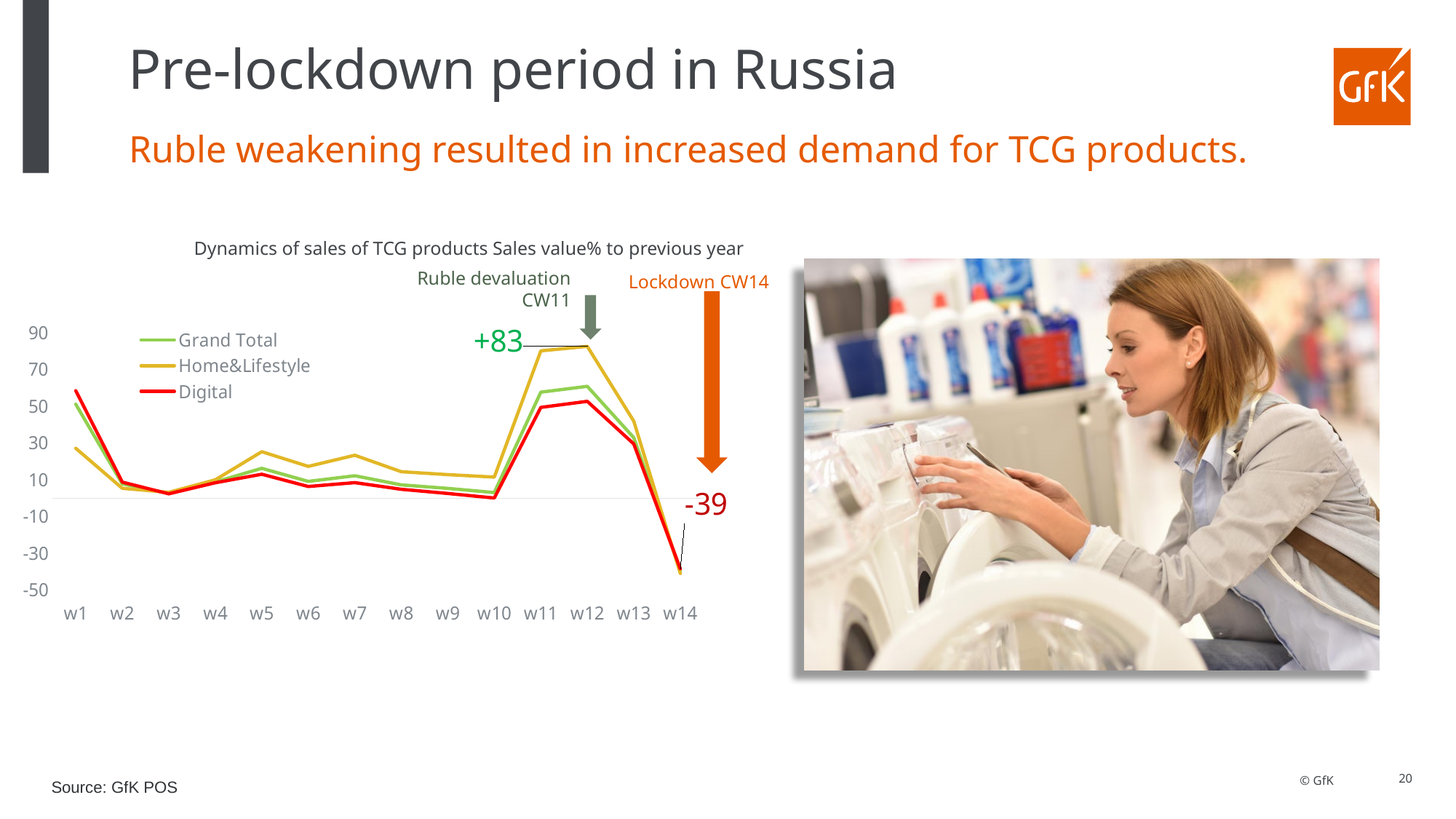
What kind of chart is shown on the slide? line chart How many series does the chart legend list? 3 Is the value for Digital at w1 greater or less than 50? greater What is the labelled value of the Home&Lifestyle series at w14? -39 Is the value for Grand Total at w12 greater or less than 50? greater At w1, which series has the higher value: Digital or Home&Lifestyle? Digital In which week does the Home&Lifestyle series reach its lowest value? w14 How many weeks are plotted along the x axis of the chart? 14 What is the title of the chart? Dynamics of sales of TCG products Sales value% to previous year Do the values of all three series rise or fall from w12 to w14? fall What is the labelled value of the Home&Lifestyle series at w12? +83 In which week does the Home&Lifestyle series reach its highest value? w12